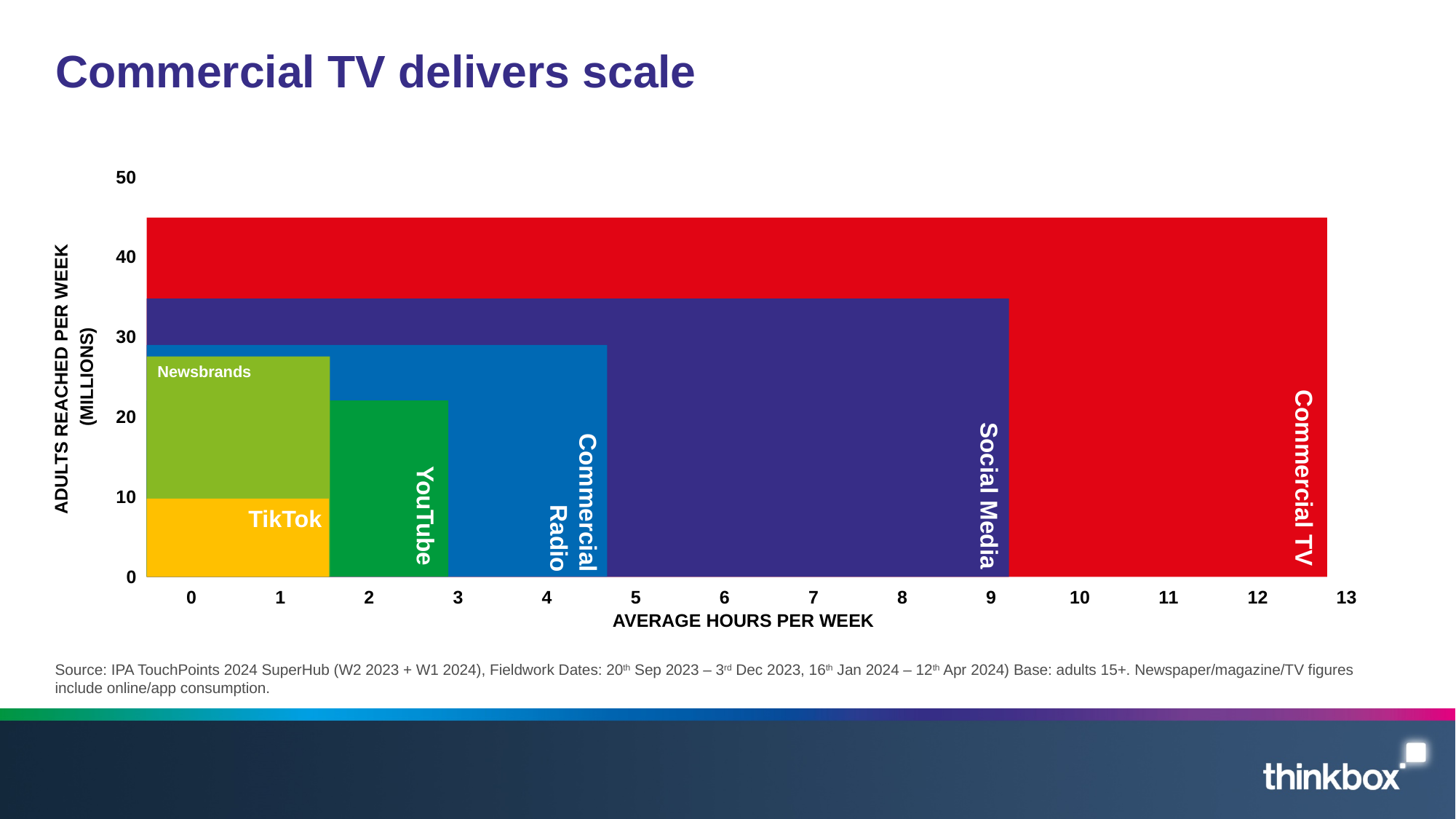
Is the adults reached per week value for Social Media greater or less than 30 million? greater Which medium has the highest average hours per week? Commercial TV What colour is the Commercial TV block? Red Is the adults reached per week value for Commercial TV greater or less than 40 million? greater Which medium reaches the most adults per week? Commercial TV How many media are shown in the chart? 6 Which medium has the lowest adults reached per week? TikTok Is the average hours per week for Commercial TV greater or less than 12? greater Which reaches more adults per week, Social Media or Commercial Radio? Social Media What is the title of the x axis? AVERAGE HOURS PER WEEK